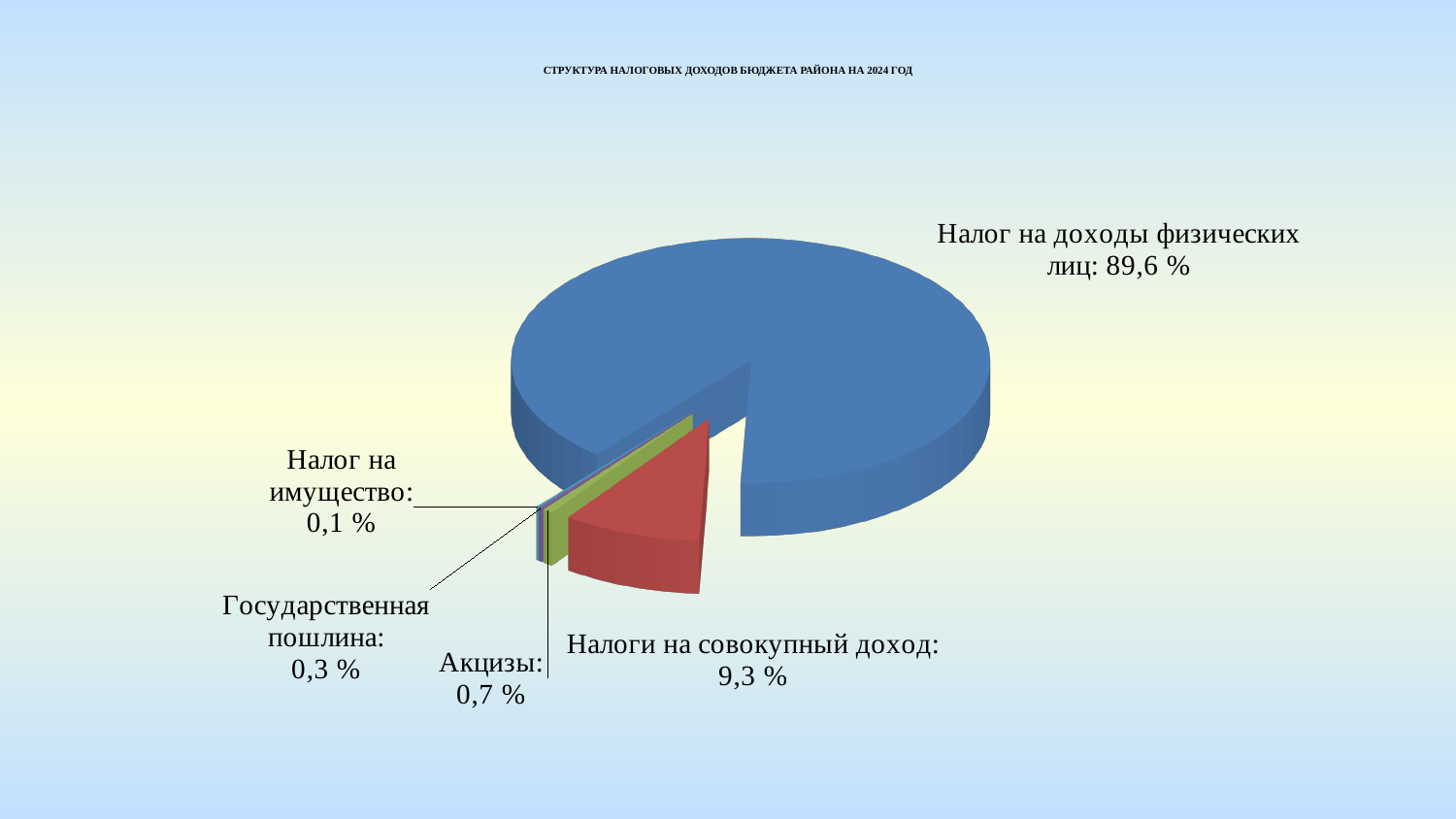
Which category has the largest share of the pie? Налог на доходы физических лиц Which is larger: the share for "Акцизы" or the share for "Государственная пошлина"? Акцизы What value is shown for "Налоги на совокупный доход"? 9,3 % What value is shown for "Государственная пошлина"? 0,3 % What type of chart is shown on the slide? Pie chart What is the difference between the shares of "Налог на доходы физических лиц" and "Налоги на совокупный доход"? 80,3 % What value is shown for "Налог на имущество"? 0,1 % Which category has the smallest share of the pie? Налог на имущество How many slices does the pie chart have? 5 What is the title of the chart on the slide? СТРУКТУРА НАЛОГОВЫХ ДОХОДОВ БЮДЖЕТА РАЙОНА НА 2024 ГОД What value is shown for "Акцизы"? 0,7 % What share of the pie is labelled for "Налог на доходы физических лиц"? 89,6 %